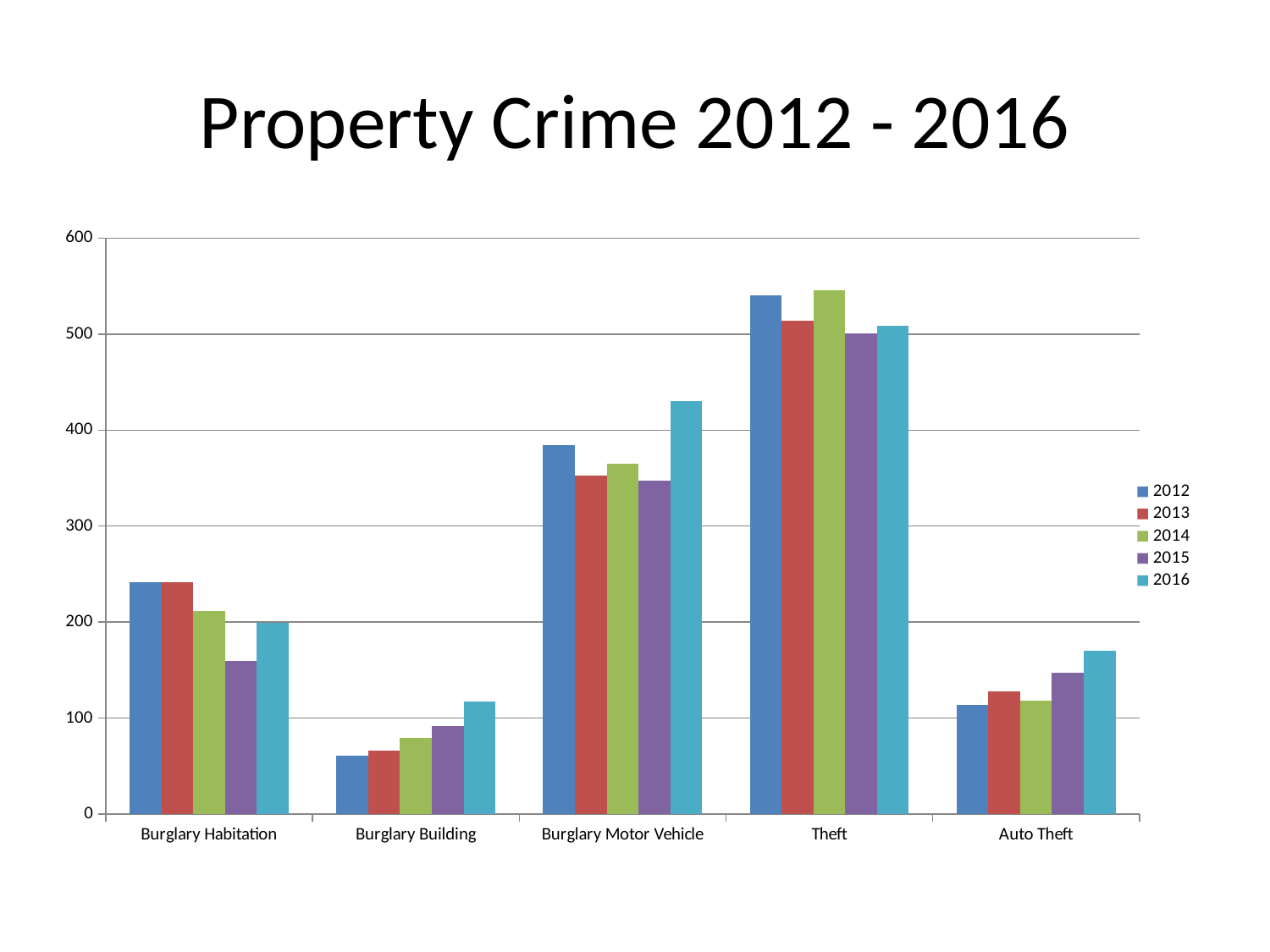
Is the 2012 value for Burglary Building greater or less than 100? less Is the 2015 value for Burglary Habitation greater or less than 200? less How many series does the legend list? 5 How many crime categories are shown along the x axis? 5 Which crime category has the lowest bars overall? Burglary Building Is the 2012 value for Theft greater or less than 500? greater What kind of chart is shown on the slide? Bar chart Which year has the highest value for Burglary Motor Vehicle? 2016 Which is larger in 2016: Auto Theft or Burglary Building? Auto Theft Which crime category has the tallest bars? Theft Do the Burglary Building values rise or fall from 2012 to 2016? rise